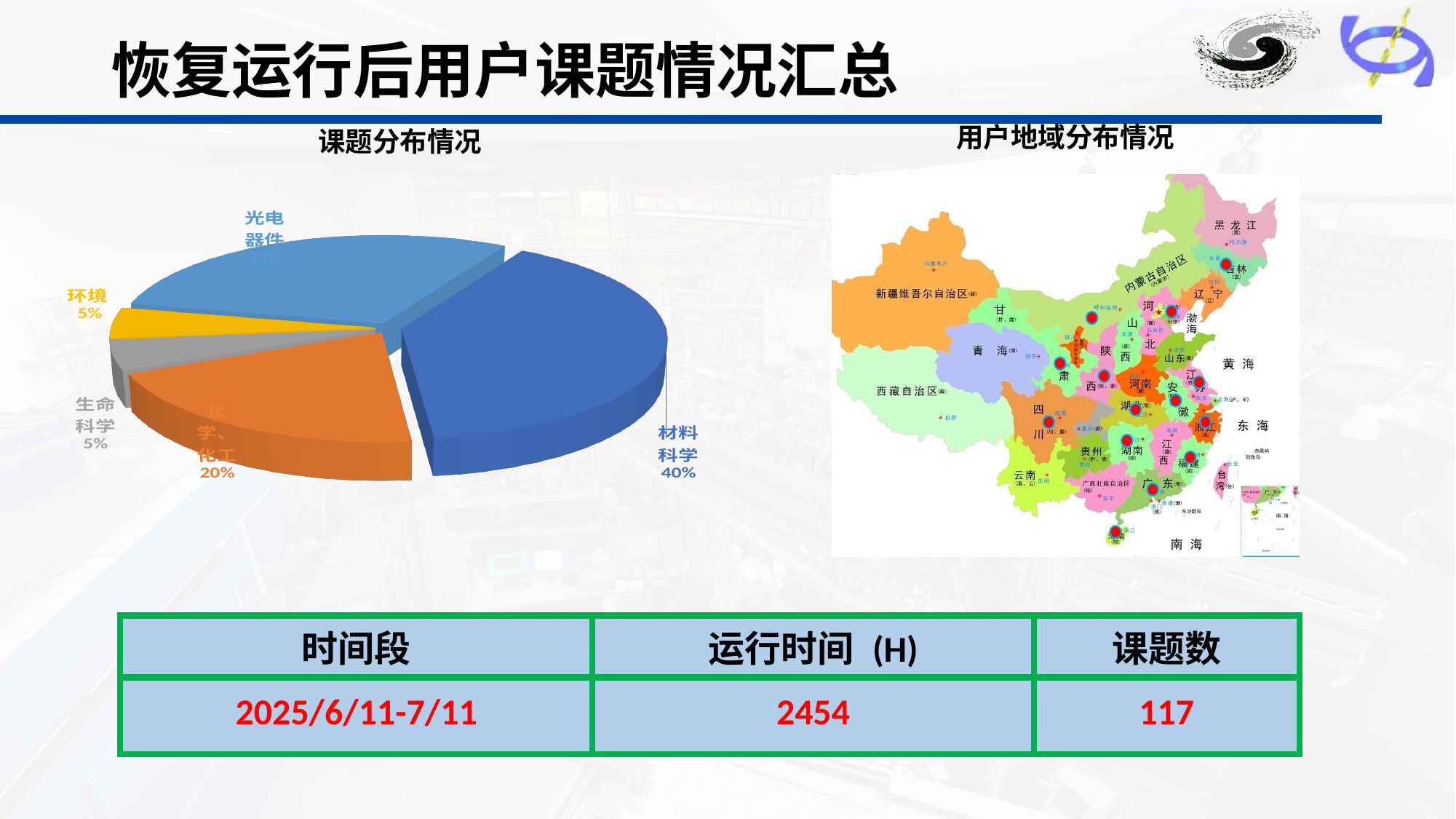
In the pie chart 课题分布情况, what share does 光电器件 have? 30% What is the title of the pie chart on the left of the slide? 课题分布情况 In the pie chart 课题分布情况, what share does 环境 have? 5% How many categories are shown in the pie chart 课题分布情况? 5 In the pie chart 课题分布情况, what share does 化学、化工 have? 20% In the pie chart 课题分布情况, what share does 生命科学 have? 5% In the pie chart 课题分布情况, which has the larger share, 光电器件 or 化学、化工? 光电器件 In the pie chart 课题分布情况, what is the combined share of 环境 and 生命科学? 10% In the pie chart 课题分布情况, how much larger is the share of 材料科学 than that of 化学、化工? 20% In the pie chart 课题分布情况, which category has the largest share? 材料科学 In the pie chart 课题分布情况, what share does 材料科学 have? 40% What kind of chart is 课题分布情况? pie chart